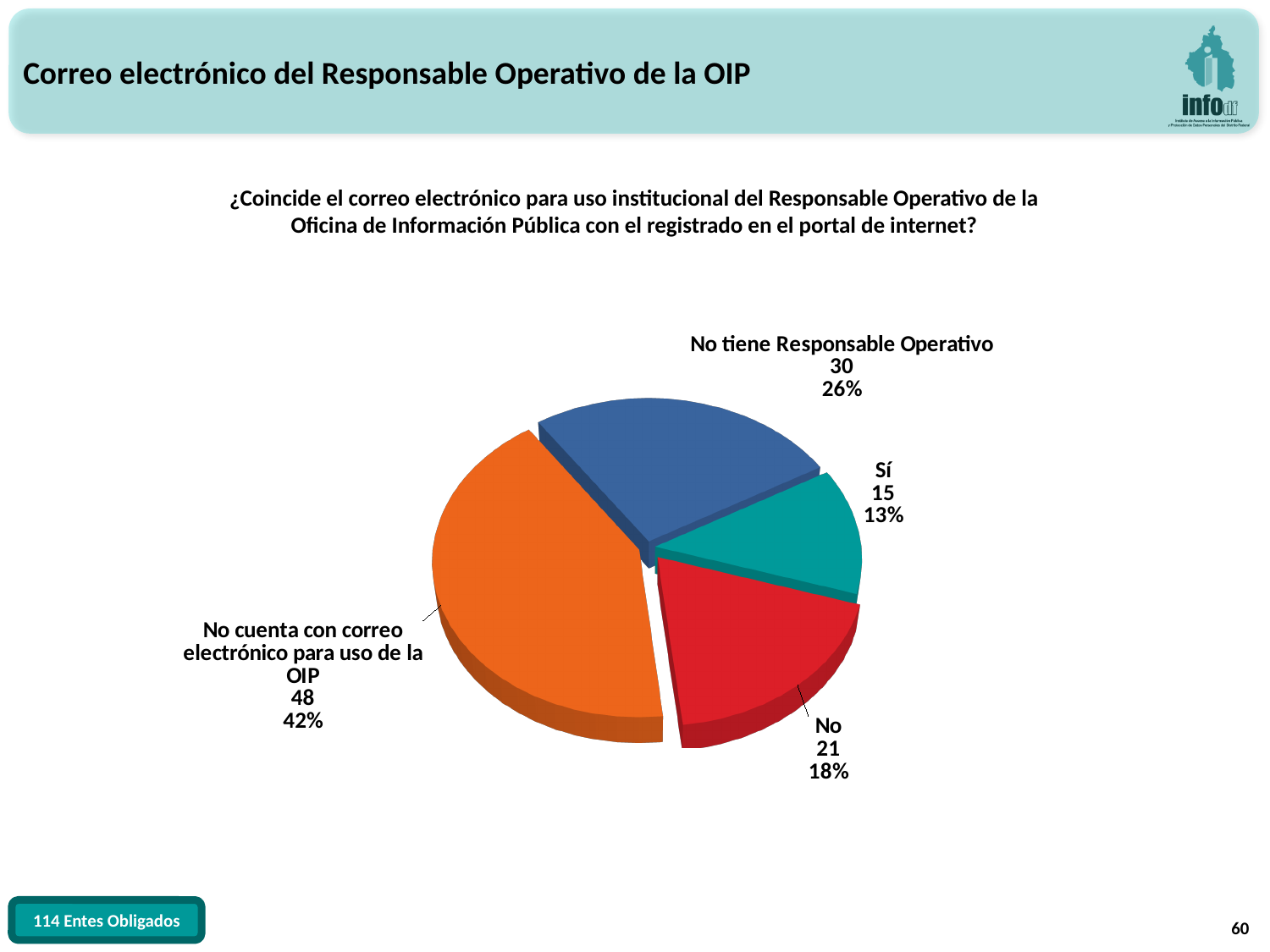
What percentage is shown for the 'No' slice? 18% What is the count for the 'Sí' slice? 15 What is the total count across all four slices? 114 What is the difference in count between 'No tiene Responsable Operativo' and 'No'? 9 What percentage is shown for 'No cuenta con correo electrónico para uso de la OIP'? 42% Which is larger, the count for 'No' or the count for 'Sí'? No How many slices does the pie chart have? 4 What colour is the 'Sí' slice? Teal What is the count for 'No tiene Responsable Operativo'? 30 Which category has the smallest slice? Sí What kind of chart is shown on the slide? Pie chart Which category has the largest slice? No cuenta con correo electrónico para uso de la OIP